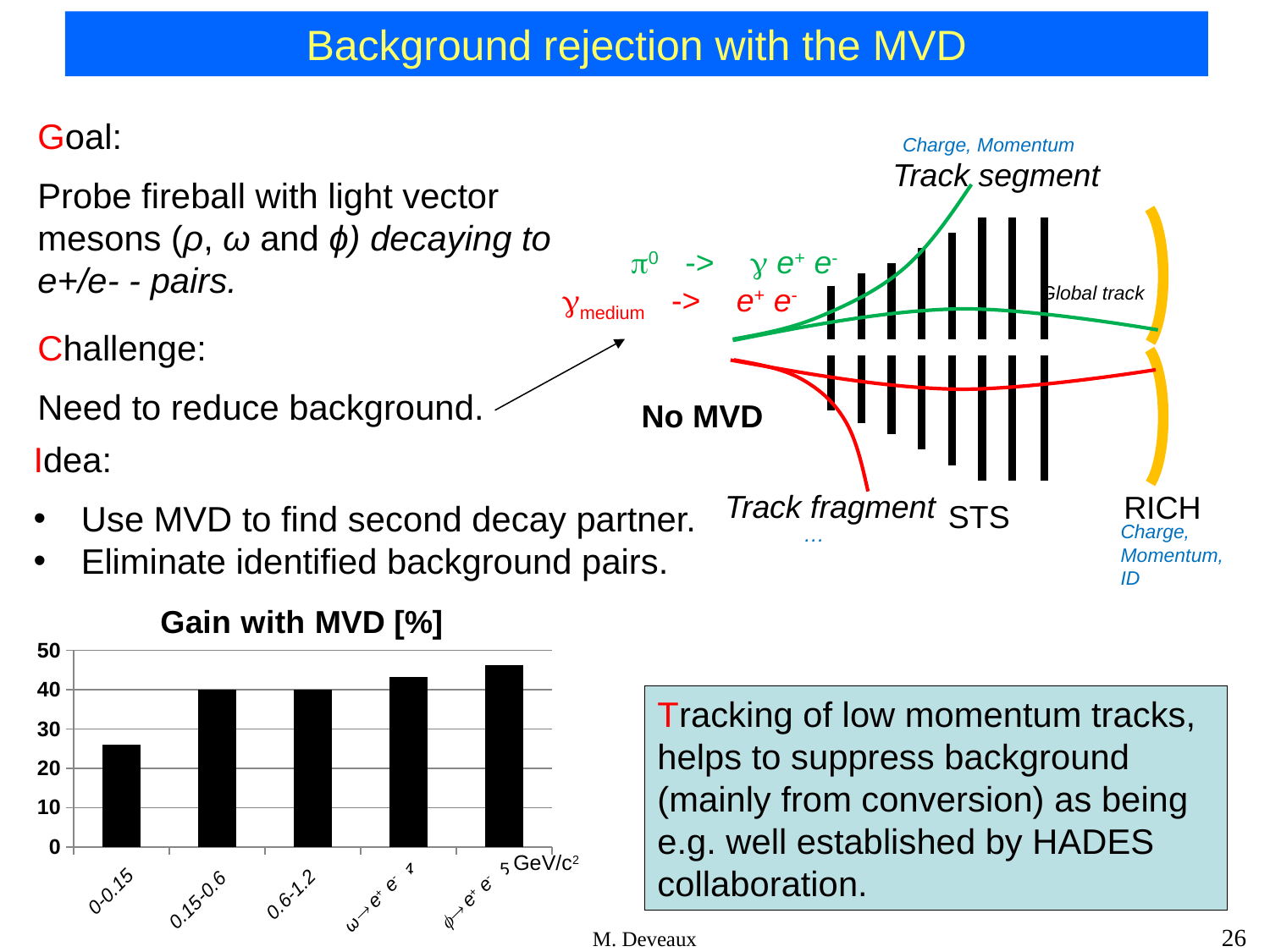
In the 'Gain with MVD [%]' chart, which is larger: the value for 0-0.15 or the value for 0.15-0.6? 0.15-0.6 How many categories are plotted in the 'Gain with MVD [%]' chart? 5 Which category has the highest value in the 'Gain with MVD [%]' chart? φ→e+e- Which category has the lowest value in the 'Gain with MVD [%]' chart? 0-0.15 What kind of chart is shown under the title 'Gain with MVD [%]'? bar chart In the 'Gain with MVD [%]' chart, is the value for ω→e+e- greater or less than 30? greater In the 'Gain with MVD [%]' chart, which is larger: the value for ω→e+e- or the value for 0-0.15? ω→e+e- What is the title of the bar chart on the slide? Gain with MVD [%] In the 'Gain with MVD [%]' chart, is the value for φ→e+e- greater or less than 40? greater In the 'Gain with MVD [%]' chart, is the value for 0-0.15 greater or less than 30? less Do the values in the 'Gain with MVD [%]' chart generally rise or fall from left to right along the x axis? rise